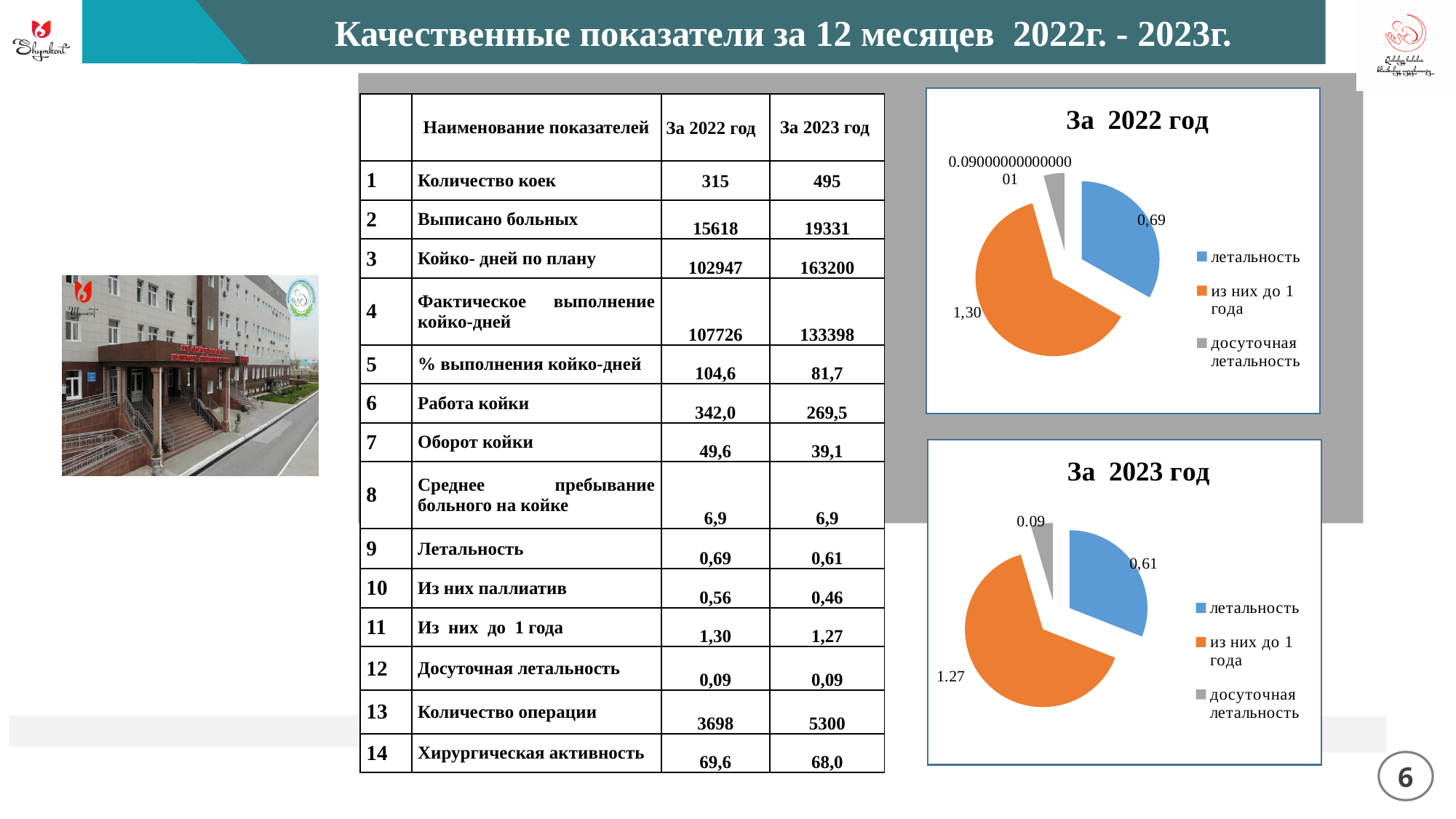
How many series does the legend of the chart titled "За 2023 год" list? 3 In the chart titled "За 2022 год", what colour is the slice for из них до 1 года? orange In the chart titled "За 2023 год", what is the value for досуточная летальность? 0.09 In the chart titled "За 2023 год", what is the value for из них до 1 года? 1.27 In the chart titled "За 2022 год", what is the value for летальность? 0,69 In the chart titled "За 2023 год", which is larger: летальность or из них до 1 года? из них до 1 года In the chart titled "За 2023 год", what is the difference between из них до 1 года and летальность? 0.66 In the chart titled "За 2022 год", what is the value for из них до 1 года? 1,30 In the chart titled "За 2023 год", which category has the smallest slice? досуточная летальность What type of chart is the chart titled "За 2022 год"? pie chart In the chart titled "За 2022 год", which category has the largest slice? из них до 1 года In the chart titled "За 2023 год", what is the value for летальность? 0,61